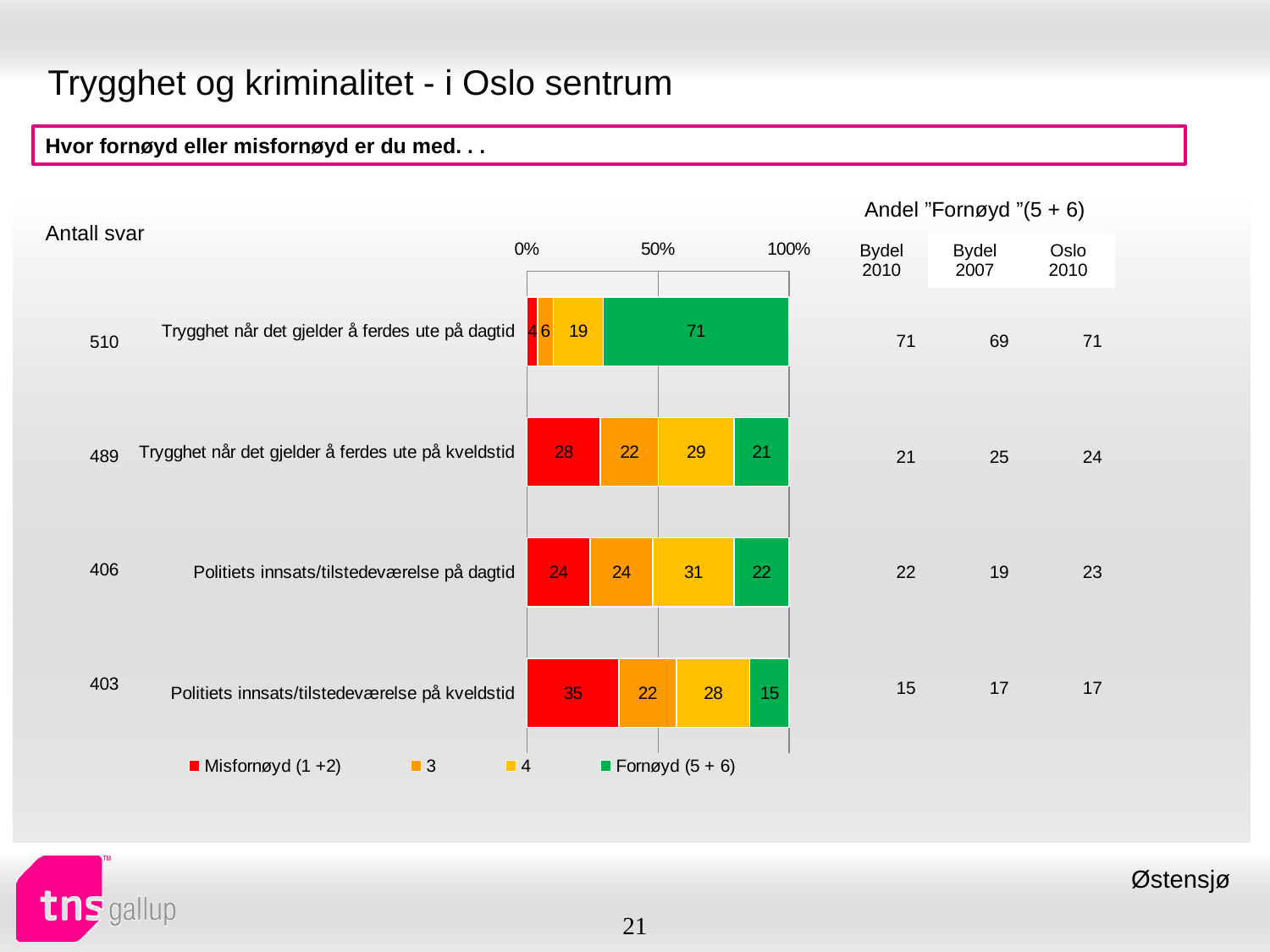
Which is larger: the Fornøyd (5 + 6) value for 'Trygghet når det gjelder å ferdes ute på kveldstid' or for 'Politiets innsats/tilstedeværelse på dagtid'? Politiets innsats/tilstedeværelse på dagtid What is the Misfornøyd (1 +2) value for 'Politiets innsats/tilstedeværelse på kveldstid'? 35 What is the difference between the Misfornøyd (1 +2) values for 'Politiets innsats/tilstedeværelse på kveldstid' and 'Politiets innsats/tilstedeværelse på dagtid'? 11 What kind of chart is shown on the slide? Stacked bar chart Which category has the highest Fornøyd (5 + 6) value? Trygghet når det gjelder å ferdes ute på dagtid What is the value of series '4' for 'Politiets innsats/tilstedeværelse på dagtid'? 31 Which category has the lowest Fornøyd (5 + 6) value? Politiets innsats/tilstedeværelse på kveldstid What is the value of series '3' for 'Trygghet når det gjelder å ferdes ute på kveldstid'? 22 What is the Fornøyd (5 + 6) value for 'Trygghet når det gjelder å ferdes ute på dagtid'? 71 How many categories are plotted in the chart? 4 Which colour represents the Fornøyd (5 + 6) series in the chart? Green How many series does the chart legend list? 4